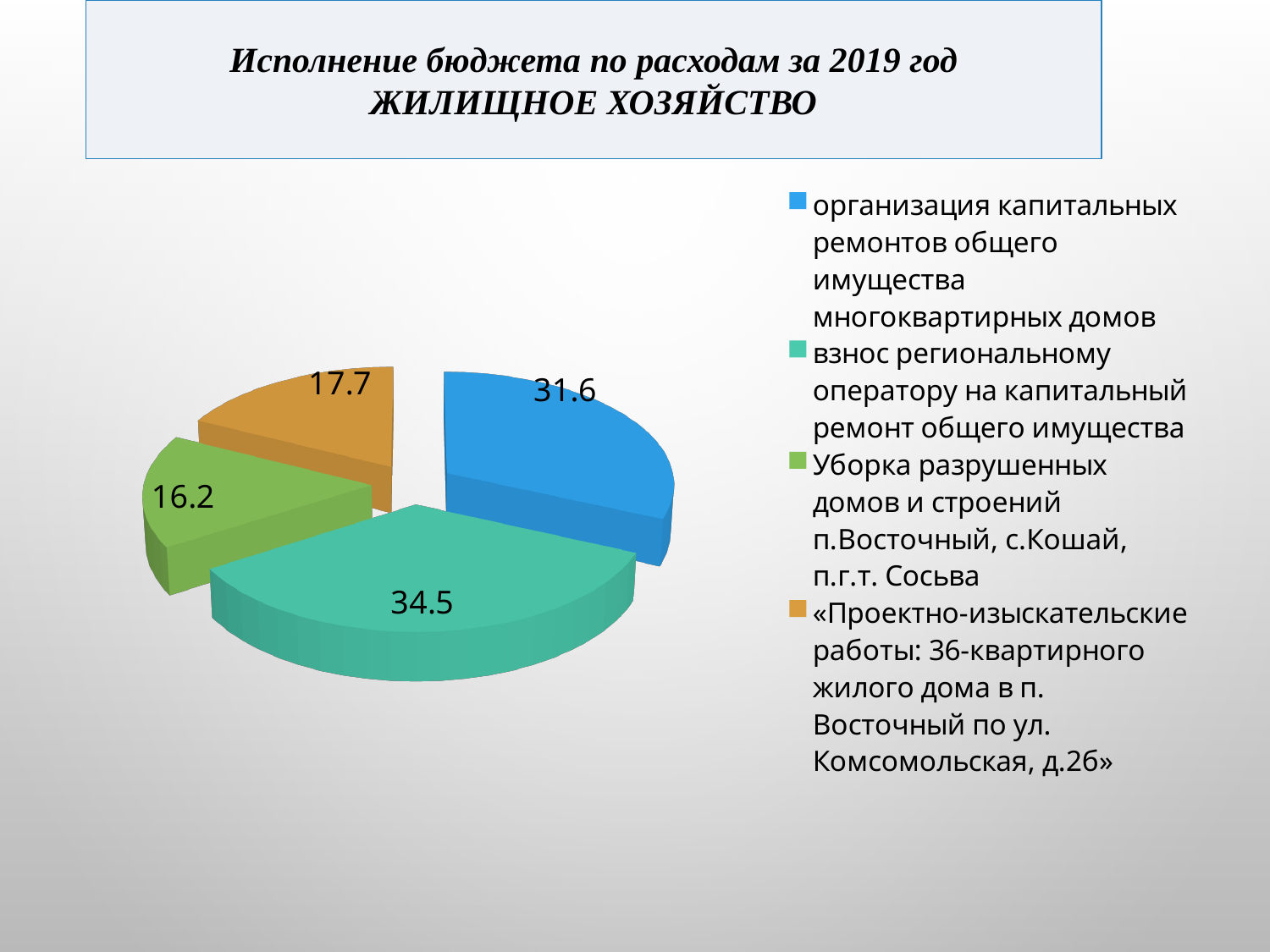
What is the value for «Уборка разрушенных домов и строений п.Восточный, с.Кошай, п.г.т. Сосьва»? 16.2 What is the difference between the values for «взнос региональному оператору» and «организация капитальных ремонтов»? 2.9 What is the difference between the values for «Проектно-изыскательские работы» and «Уборка разрушенных домов и строений»? 1.5 What kind of chart is shown on the slide? pie chart What is the value for «Проектно-изыскательские работы: 36-квартирного жилого дома в п. Восточный по ул. Комсомольская, д.2б»? 17.7 What colour is the slice for «Уборка разрушенных домов и строений»? green Which is larger: the value for «организация капитальных ремонтов» or the value for «Проектно-изыскательские работы»? организация капитальных ремонтов How many slices does the pie chart have? 4 Which category has the largest slice of the pie? взнос региональному оператору на капитальный ремонт общего имущества What is the value for «взнос региональному оператору на капитальный ремонт общего имущества»? 34.5 What is the value for «организация капитальных ремонтов общего имущества многоквартирных домов»? 31.6 Which category has the smallest slice of the pie? Уборка разрушенных домов и строений п.Восточный, с.Кошай, п.г.т. Сосьва